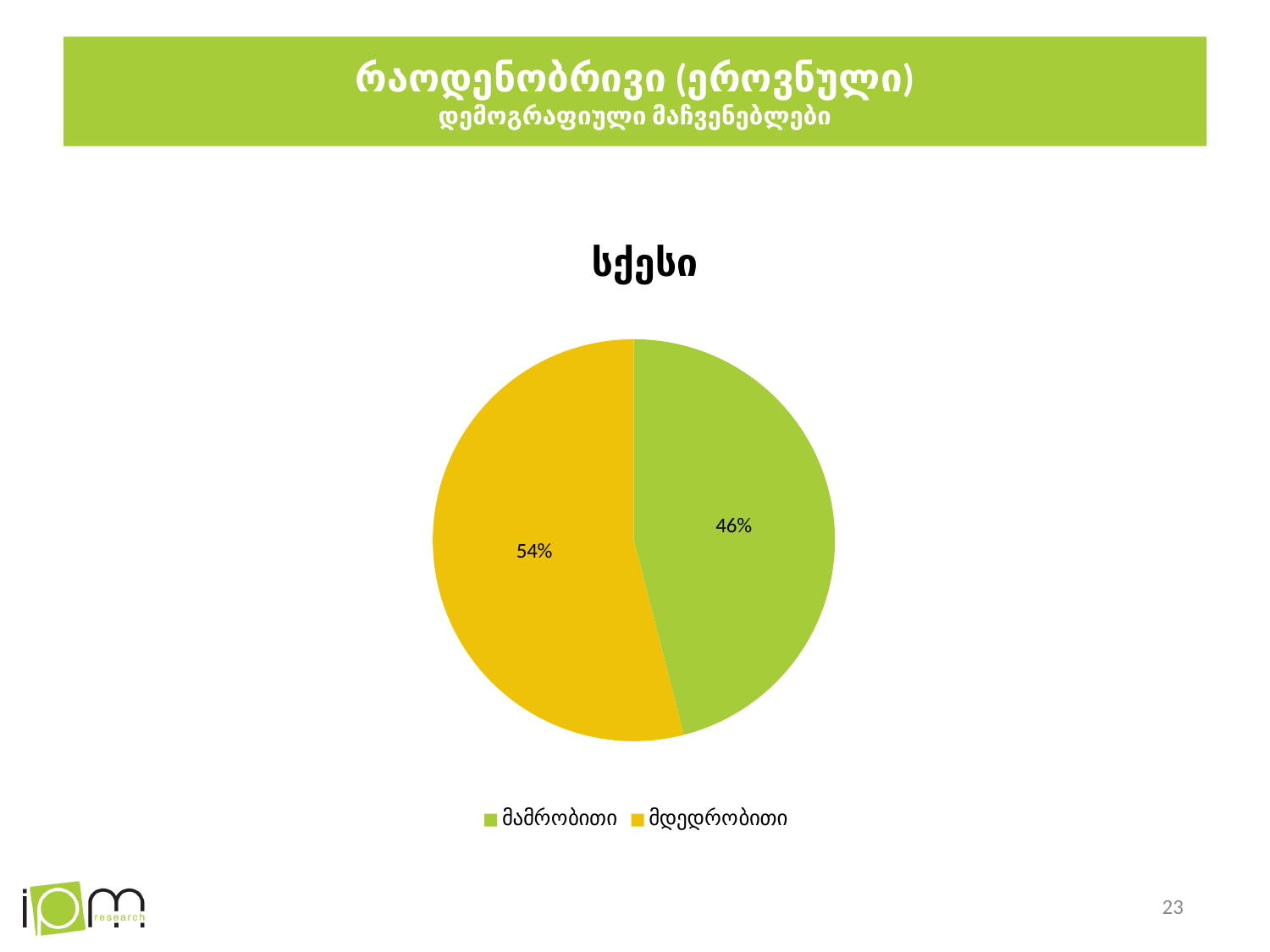
How many entries does the legend list? 2 What share of the pie is მამრობითი? 46% Which category has the largest slice of the pie? მდედრობითი What share of the pie is მდედრობითი? 54% Which category has the smallest slice of the pie? მამრობითი What colour is the slice for მდედრობითი? yellow What type of chart is shown on the slide? pie chart Which is larger, the share for მამრობითი or the share for მდედრობითი? მდედრობითი How many slices does the pie chart have? 2 What is the total of the two slices shown in the pie chart? 100% What is the difference in percentage points between მდედრობითი and მამრობითი? 8 What is the title of the chart? სქესი